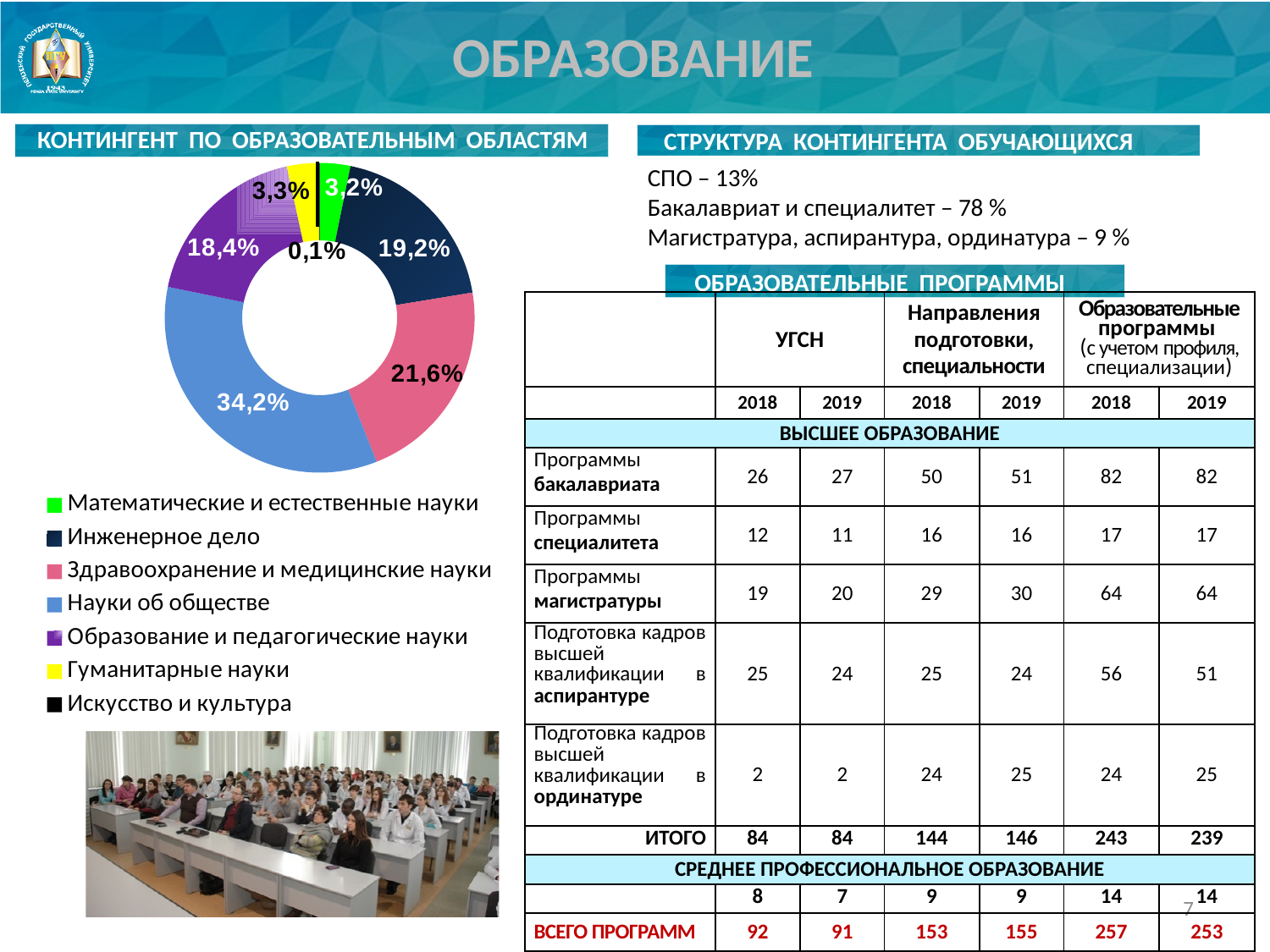
How many categories does the legend of the doughnut chart list? 7 In the doughnut chart, by how many percentage points does «Науки об обществе» exceed «Здравоохранение и медицинские науки»? 12,6 Which category has the largest share in the doughnut chart? Науки об обществе In the doughnut chart, what share is shown for «Инженерное дело»? 19,2% What kind of chart is shown under the heading «КОНТИНГЕНТ ПО ОБРАЗОВАТЕЛЬНЫМ ОБЛАСТЯМ»? Doughnut (pie) chart In the doughnut chart, which is larger: «Инженерное дело» or «Образование и педагогические науки»? Инженерное дело In the doughnut chart, what share is shown for «Образование и педагогические науки»? 18,4% In the doughnut chart, what share is shown for «Гуманитарные науки»? 3,3% Which category has the smallest share in the doughnut chart? Искусство и культура In the doughnut chart, what share is shown for «Здравоохранение и медицинские науки»? 21,6% In the doughnut chart, what share is shown for «Математические и естественные науки»? 3,2% In the doughnut chart, what share is shown for «Науки об обществе»? 34,2%